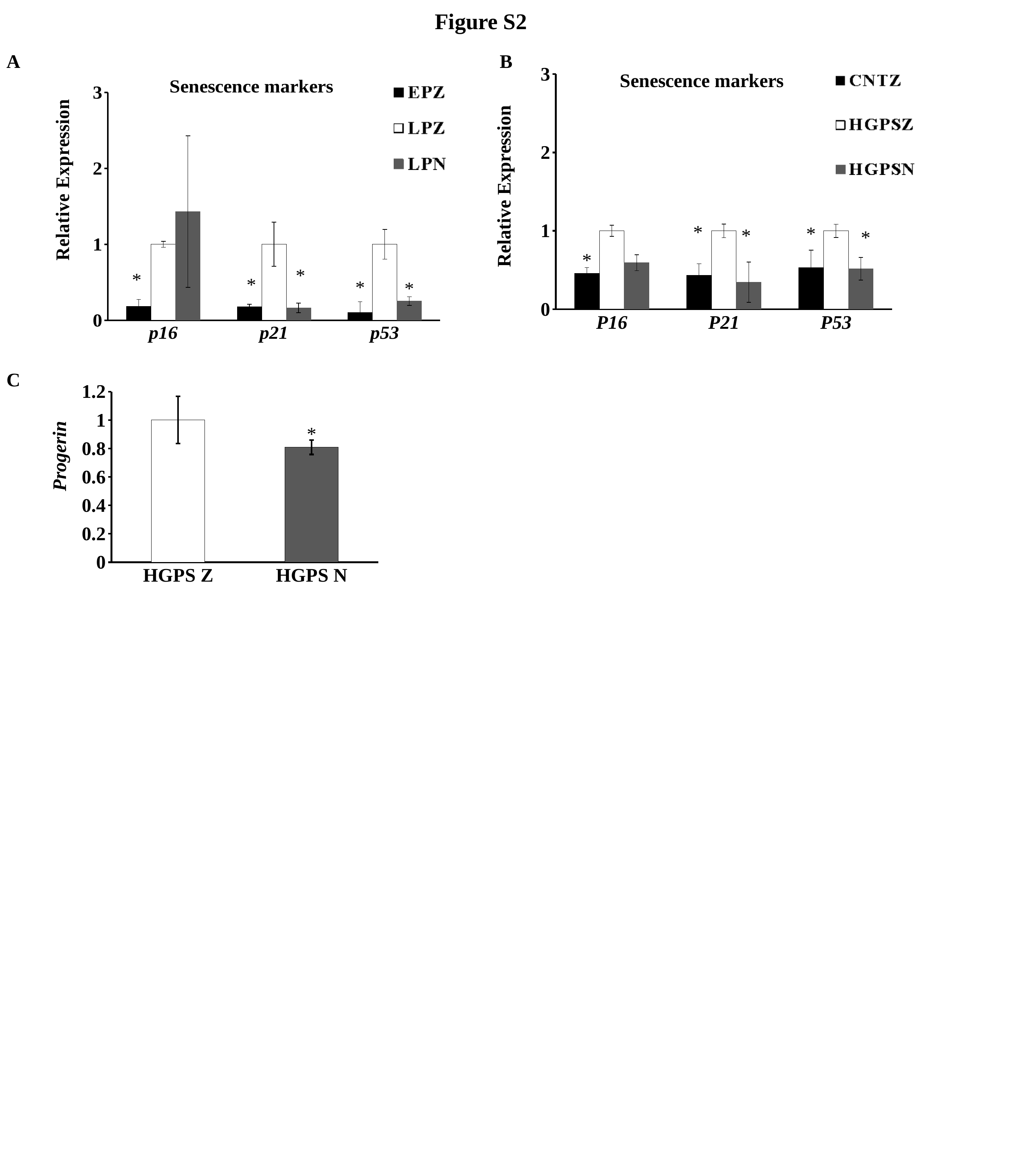
In chart B (Senescence markers, right), what is the HGPSZ value for P16? 1 In chart A (Senescence markers, left), is the LPN value for p16 greater or less than 1? greater In chart A (Senescence markers, left), what is the LPZ value for p21? 1 In chart C (Progerin, bottom left), what is the value for HGPS Z? 1 In chart A (Senescence markers, left), how many gene categories are shown on the x axis? 3 In chart A (Senescence markers, left), what kind of chart is shown? bar chart In chart A (Senescence markers, left), which series has the highest value for p16? LPN In chart C (Progerin, bottom left), which of HGPS Z and HGPS N has the larger value? HGPS Z In chart B (Senescence markers, right), how many series does the legend list? 3 In chart B (Senescence markers, right), which series has the highest value for P21? HGPSZ In chart A (Senescence markers, left), is the EPZ value for p53 greater or less than 1? less In chart A (Senescence markers, left), how many series does the legend list? 3